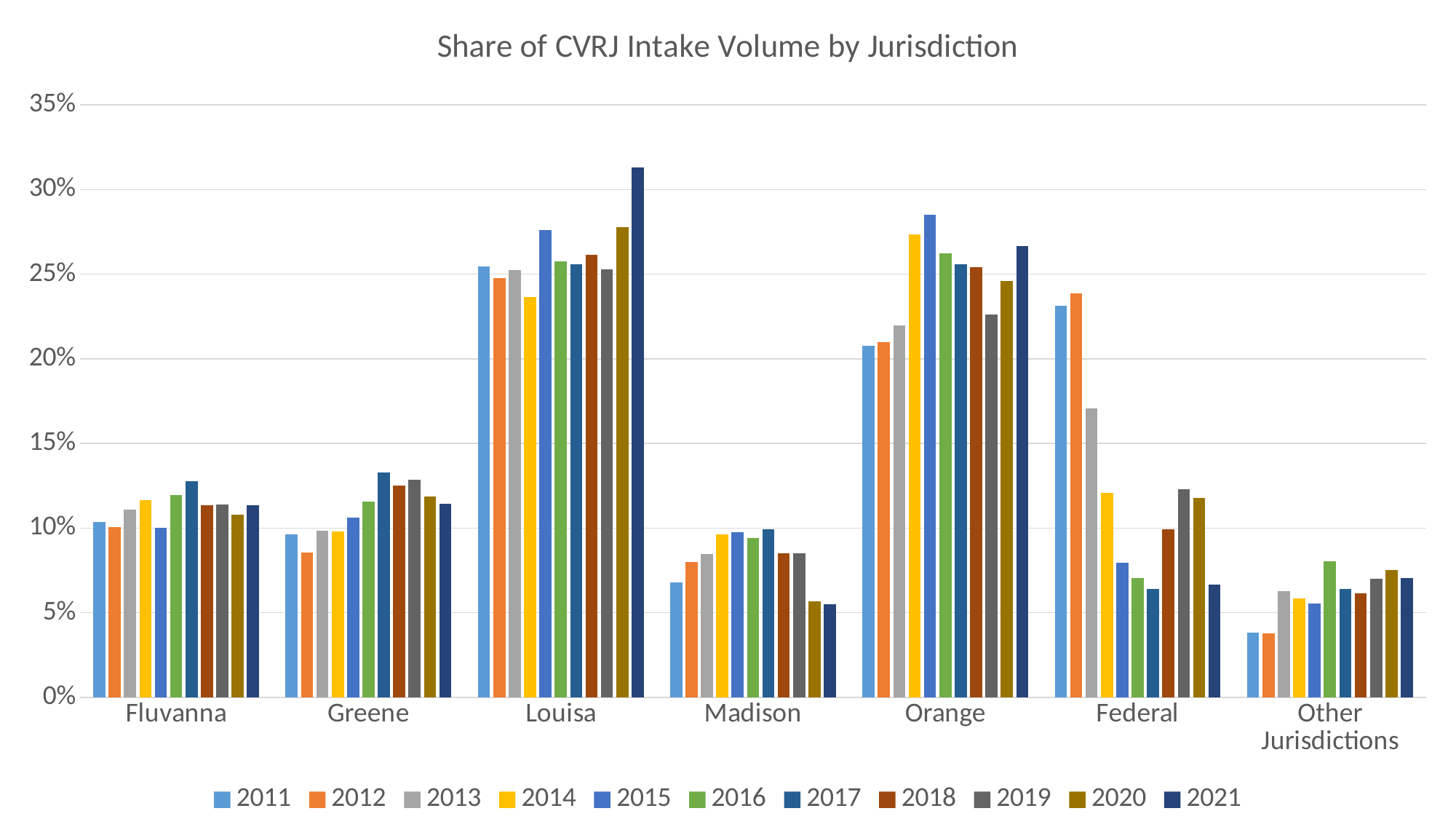
Which is larger for Federal: the 2011 value or the 2021 value? 2011 For Louisa, which year has the highest value? 2021 Is the value for Other Jurisdictions in 2011 greater or less than 5%? less How many series does the legend list? 11 What is the title of the chart? Share of CVRJ Intake Volume by Jurisdiction What type of chart is shown on the slide? bar chart Is the value for Madison in 2021 greater or less than 10%? less How many jurisdiction categories are shown on the x axis? 7 Is the value for Greene in 2017 greater or less than 10%? greater Do the Federal values rise or fall from 2011 to 2017? fall Which jurisdiction has the highest value for 2021? Louisa